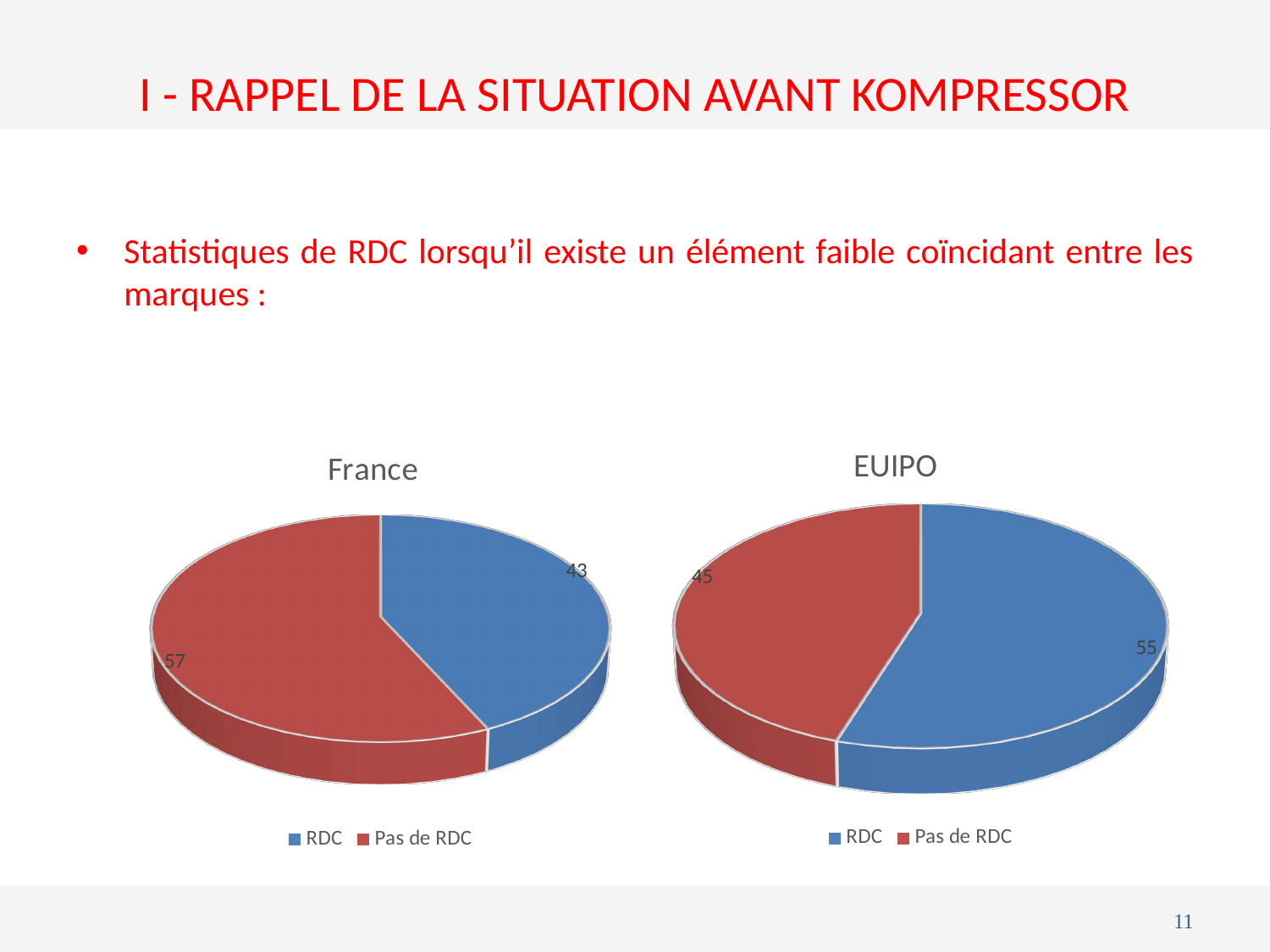
In the France chart, what is the difference between Pas de RDC and RDC? 14 In the EUIPO chart, what is the value for RDC? 55 What type of chart is the France chart? Pie chart In the France chart, which slice is the largest? Pas de RDC In the EUIPO chart, what is the difference between RDC and Pas de RDC? 10 Which is larger: RDC in the France chart or RDC in the EUIPO chart? RDC in the EUIPO chart How many entries does the legend of the France chart list? 2 How many slices does the EUIPO chart have? 2 In the EUIPO chart, what is the value for Pas de RDC? 45 In the EUIPO chart, which slice is the smallest? Pas de RDC In the France chart, what is the value for Pas de RDC? 57 In the France chart, what is the value for RDC? 43